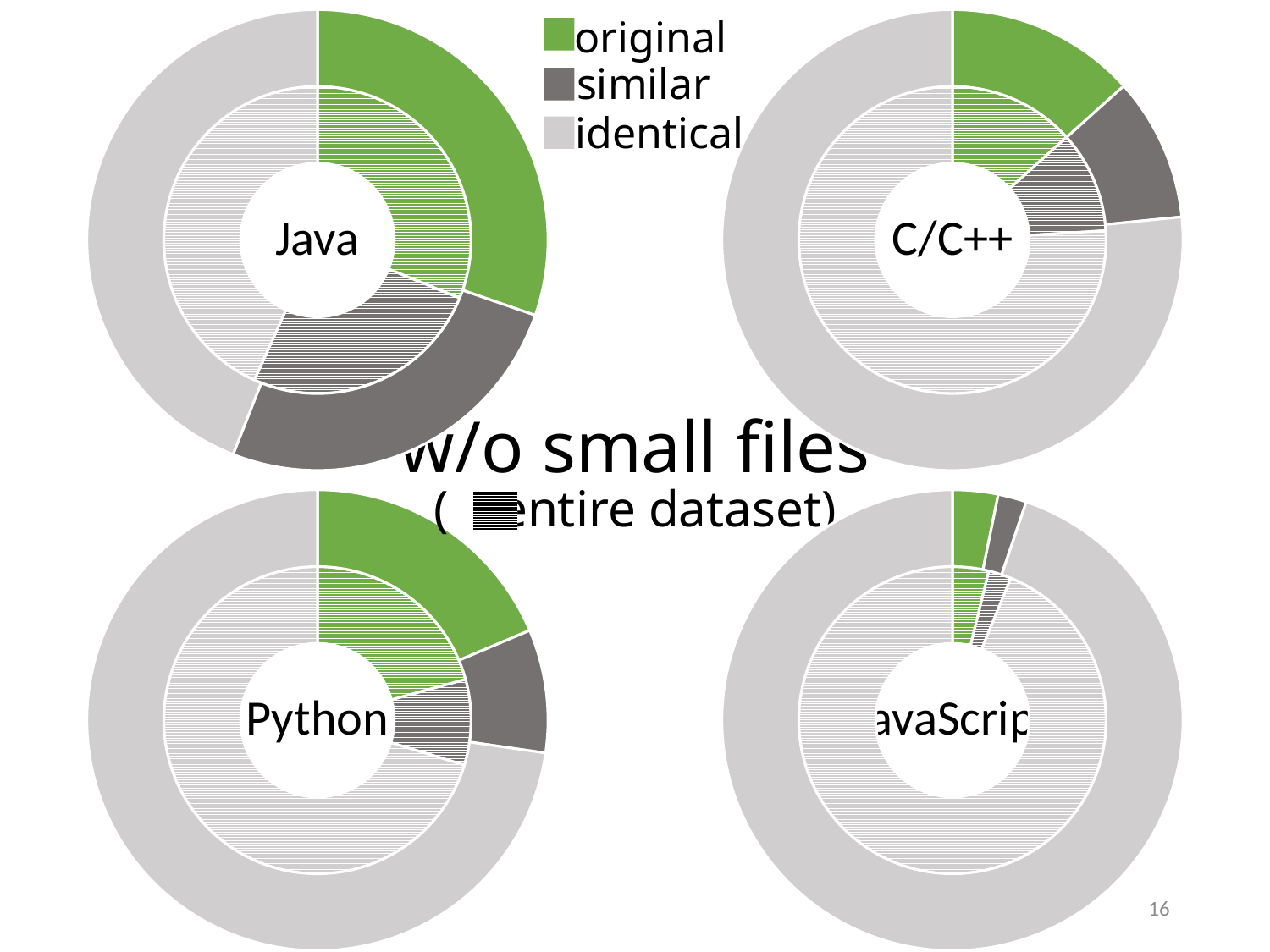
In the C/C++ chart, which category has the smallest share? similar Which chart has the larger original share: Java or JavaScript? Java What kind of chart is the Java chart? doughnut chart Which colour represents the 'original' category in the charts? green How many charts are shown on the slide? 4 In the JavaScript chart, which category has the smallest share? similar What does the inner (hatched) ring of each chart represent? entire dataset In the Python chart, which category has the smallest share? similar How many categories does the legend list? 3 In the JavaScript chart, which category has the largest share? identical In the Java chart, which category has the largest share? identical In the C/C++ chart's outer ring, which is larger: the original share or the similar share? original